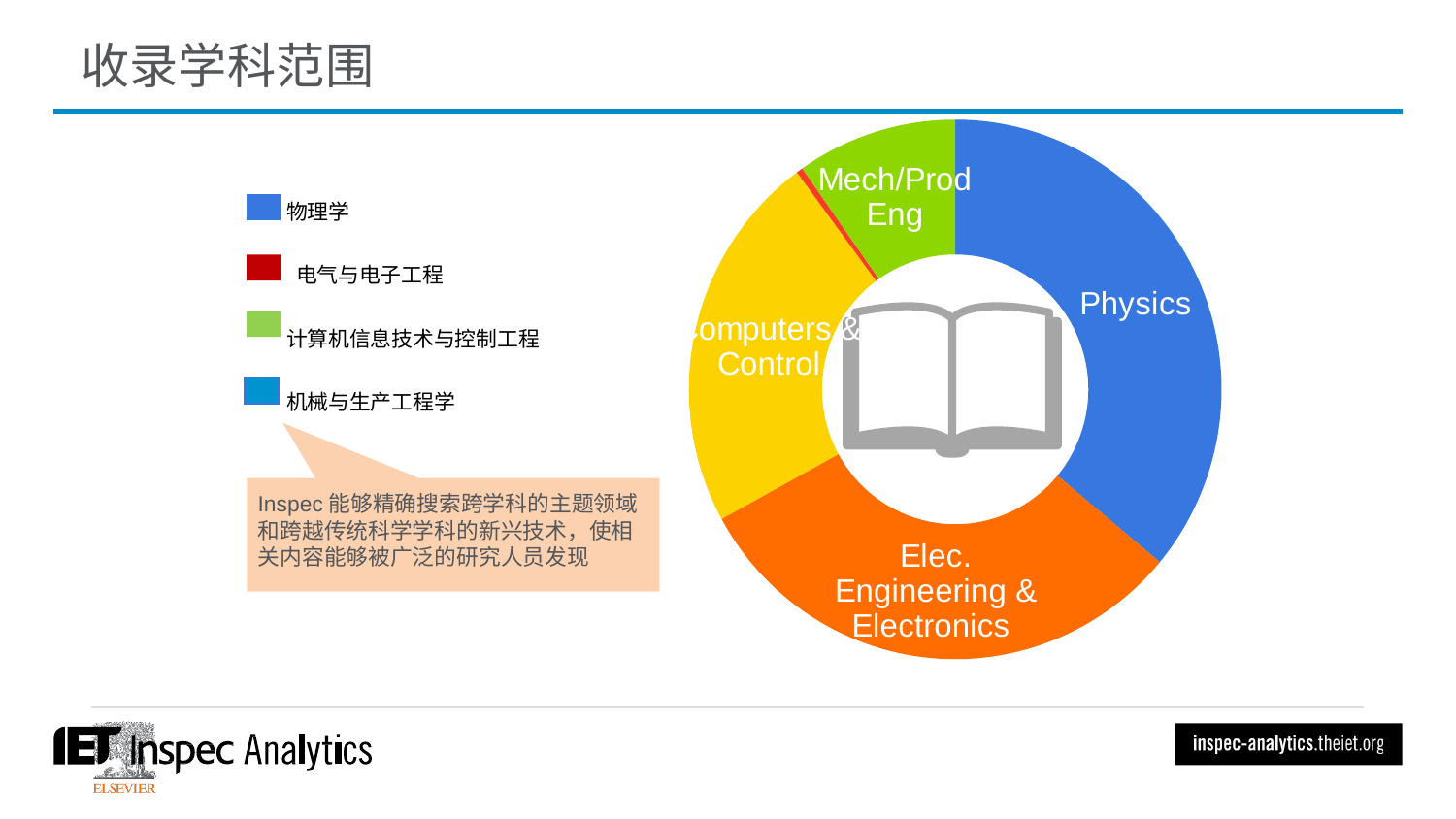
What is the label of the blue segment of the donut chart? Physics How many labeled segments does the donut chart have? 4 Which segment of the donut chart is the largest? Physics Which segment is larger, Computers & Control or Mech/Prod Eng? Computers & Control What is the label of the orange segment of the donut chart? Elec. Engineering & Electronics Which segment is larger, Elec. Engineering & Electronics or Computers & Control? Elec. Engineering & Electronics Which labeled segment of the donut chart is the smallest? Mech/Prod Eng What kind of chart is shown on the slide? Donut (pie) chart Which segment is larger, Physics or Mech/Prod Eng? Physics